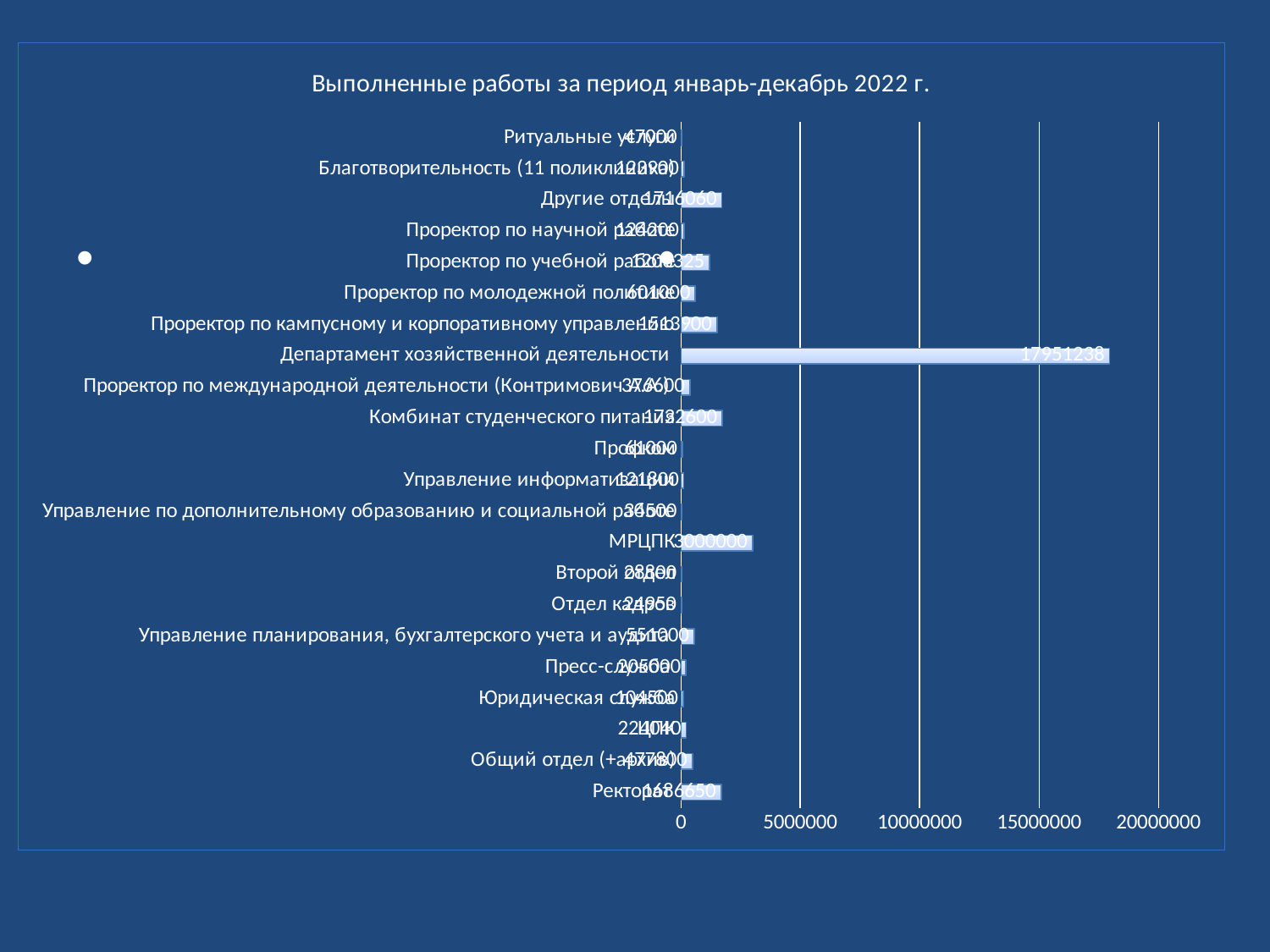
What is the highest value shown on the horizontal axis? 20000000 What is the value for МРЦПК? 3000000 Which is larger, the value for Департамент хозяйственной деятельности or the value for МРЦПК? Департамент хозяйственной деятельности Is the value for Ректорат greater or less than 5000000? less Is the value for Департамент хозяйственной деятельности greater or less than 15000000? greater What kind of chart is shown on the slide? bar chart How many bars does the chart show? 22 What is the difference between the value for Департамент хозяйственной деятельности and the value for МРЦПК? 14951238 Which category has the highest value? Департамент хозяйственной деятельности What is the value for Департамент хозяйственной деятельности? 17951238 Is the value for МРЦПК greater or less than 5000000? less What is the title of the chart? Выполненные работы за период январь-декабрь 2022 г.